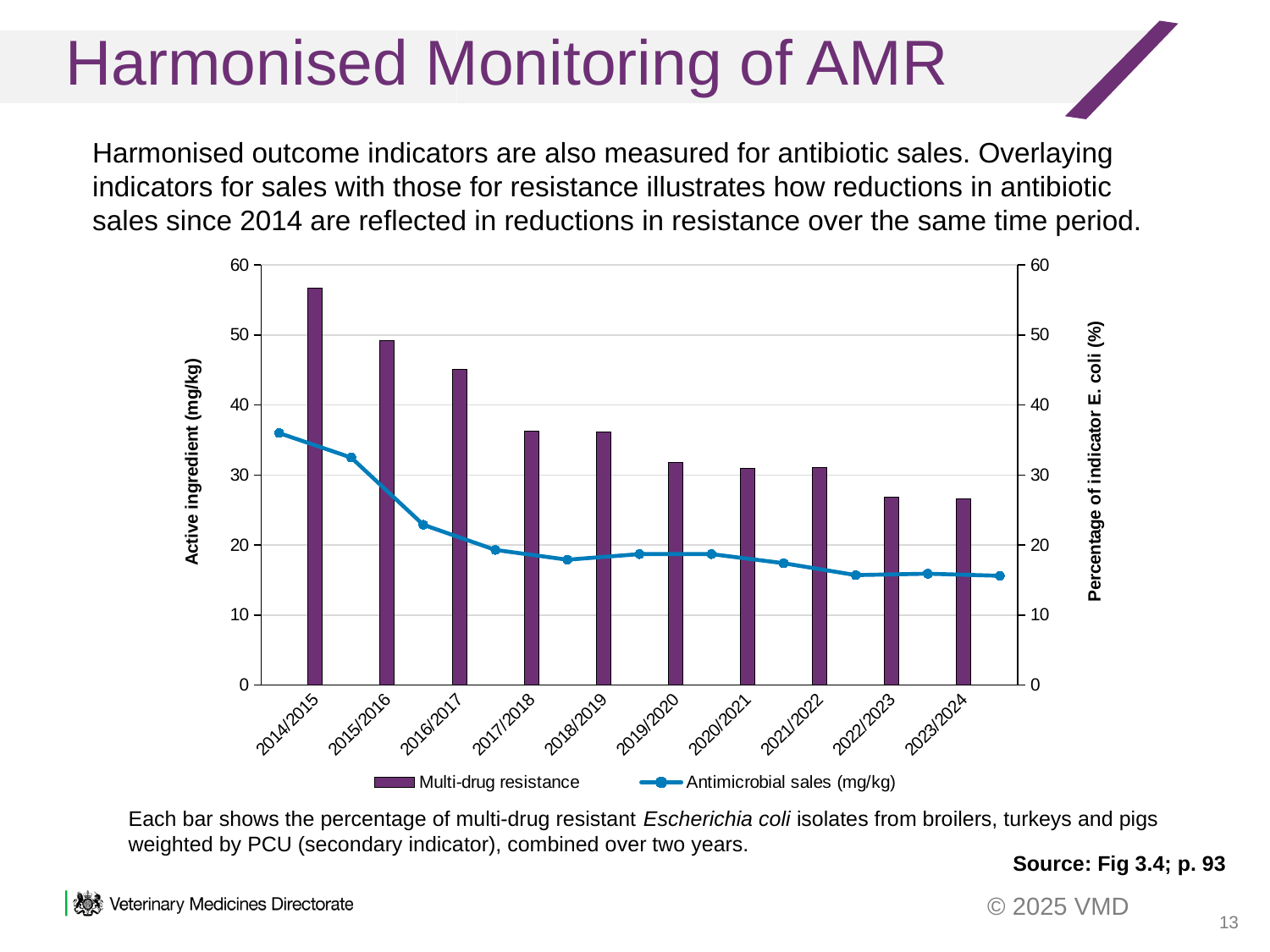
Which year has the highest Multi-drug resistance bar? 2014/2015 In which year is the Antimicrobial sales (mg/kg) line at its highest? 2014/2015 Which is larger, the Multi-drug resistance bar for 2015/2016 or for 2017/2018? 2015/2016 Is the Antimicrobial sales (mg/kg) value for 2018/2019 greater or less than 20? less What is the overall trend of the Multi-drug resistance bars from 2014/2015 to 2023/2024? Falling Which is larger, the Antimicrobial sales (mg/kg) value for 2014/2015 or for 2016/2017? 2014/2015 Is the Multi-drug resistance value for 2016/2017 greater or less than 40? greater How many series does the legend list? 2 Is the Multi-drug resistance value for 2022/2023 greater or less than 30? less How many year categories are shown on the x axis? 10